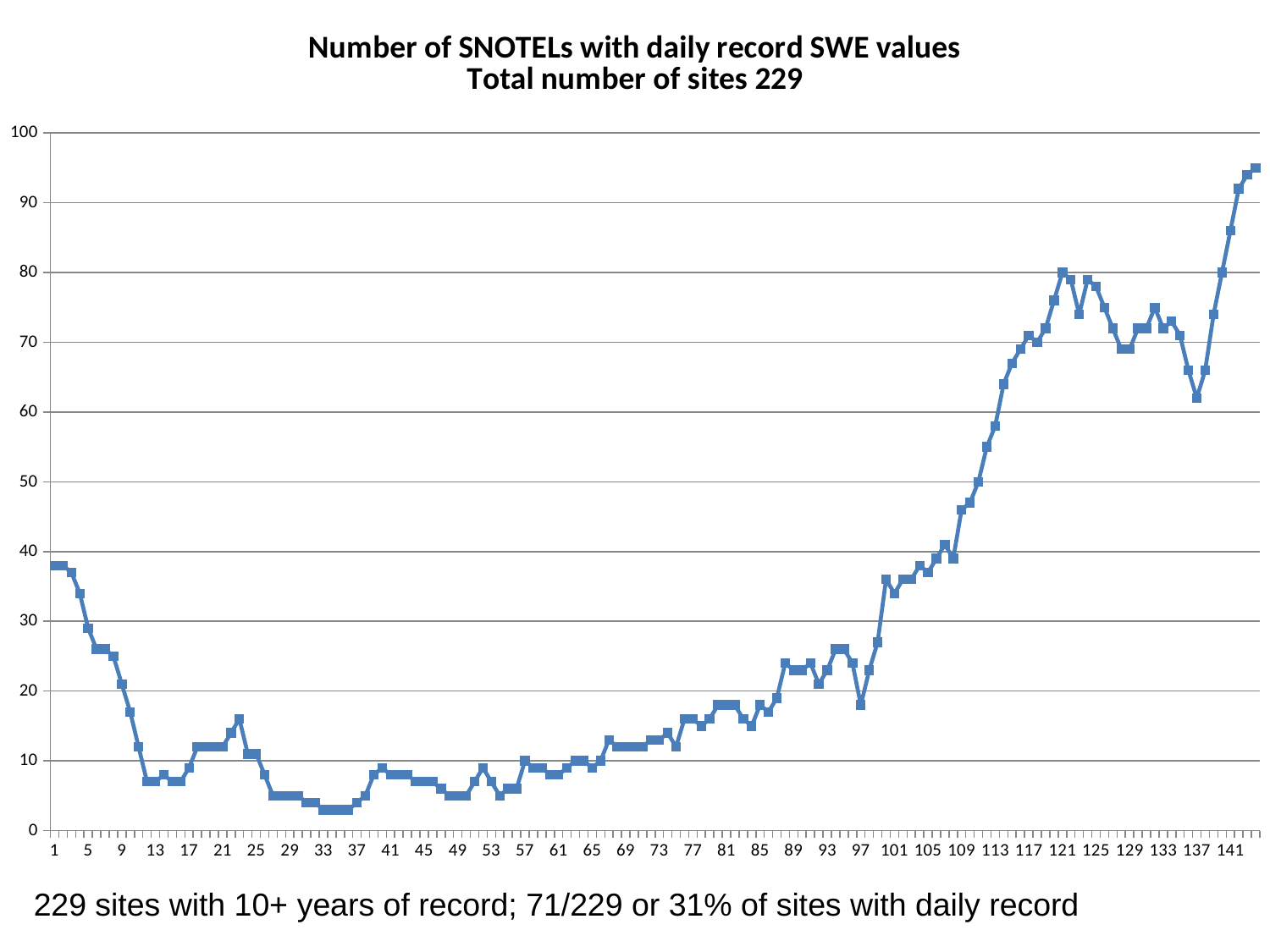
Which is larger, the value at x = 1 or the value at x = 141? x = 141 Is the value at x = 1 greater or less than 30? greater Is the value at x = 61 greater or less than 20? less Is the value at x = 33 greater or less than 10? less What is the highest value shown on the y axis? 100 Do the values rise or fall along the x axis from x = 1 to x = 13? fall What kind of chart is shown on the slide? line chart What is the title of the chart? Number of SNOTELs with daily record SWE values Total number of sites 229 Do the values rise or fall along the x axis from x = 97 to x = 121? rise